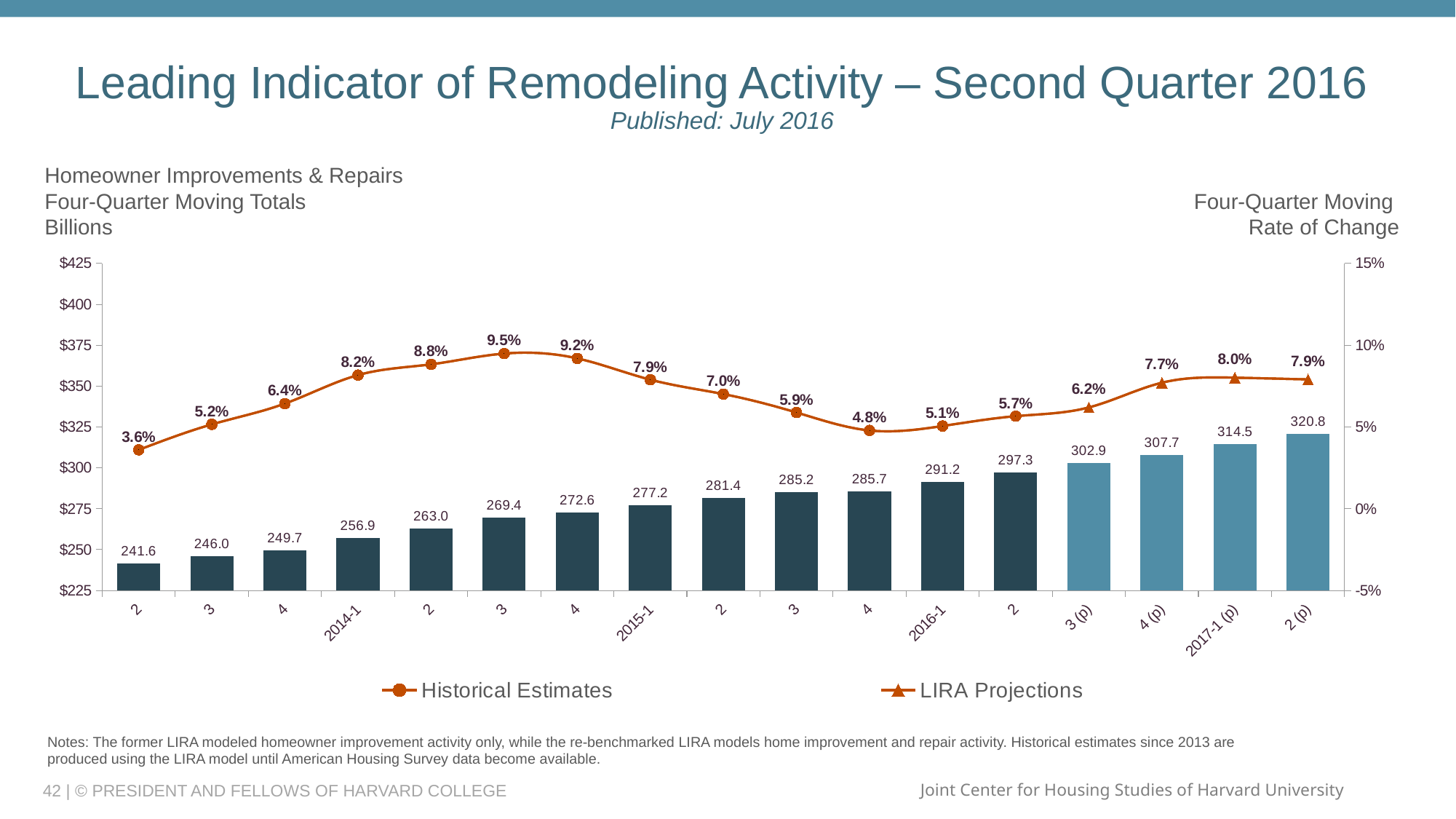
Which has a higher rate of change, 2015-1 or 2016-1? 2015-1 What is the lowest four-quarter moving rate of change shown on the line? 3.6% How many series does the legend list? 2 What is the difference between the bar values for 2 (p) and the first category (2)? 79.2 What is the highest four-quarter moving rate of change shown on the line? 9.5% How many categories are shown on the x axis? 17 What is the projected four-quarter moving total for 2017-1 (p)? 314.5 Do the bar values rise or fall from left to right along the x axis? rise Which category has the tallest bar? 2 (p) What is the four-quarter moving total (in billions) for 2015-1? 277.2 What is the four-quarter moving rate of change shown for 2014-1? 8.2% What is the difference between the bar values for 2016-1 and 2015-1? 14.0